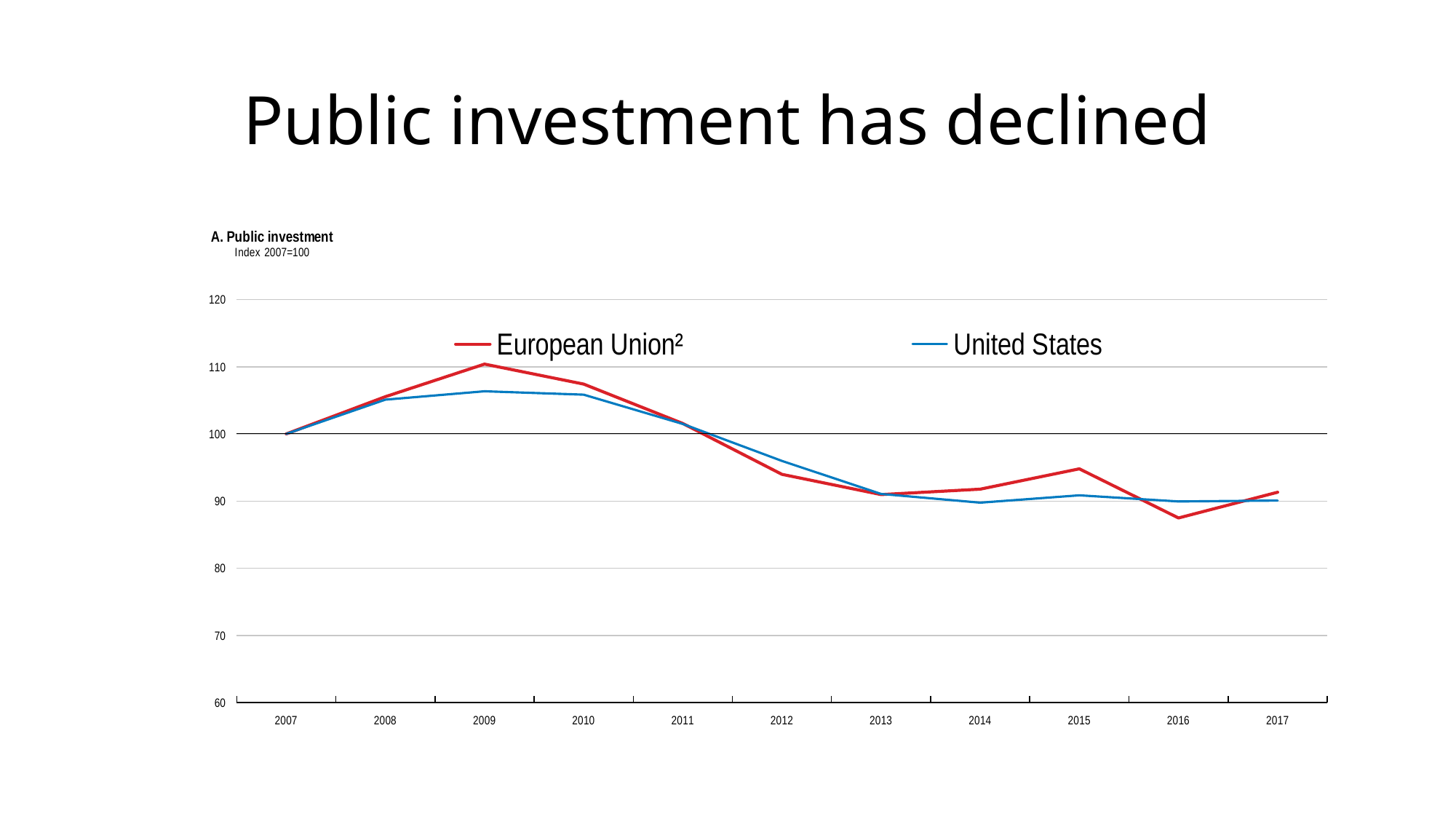
In which year does the European Union series reach its highest value? 2009 In which year does the European Union series reach its lowest value? 2016 Is the value for the European Union in 2009 greater or less than 100? greater What is the value for the European Union in 2007? 100 How many years are plotted along the x axis? 11 Which series is drawn in red? European Union In 2015, which series has the higher value, European Union or United States? European Union Is the value for the United States in 2012 greater or less than 90? greater Does the European Union series rise or fall between 2009 and 2013? fall Is the value for the European Union in 2016 greater or less than 90? less What kind of chart is shown on the slide? line chart How many series does the legend list? 2